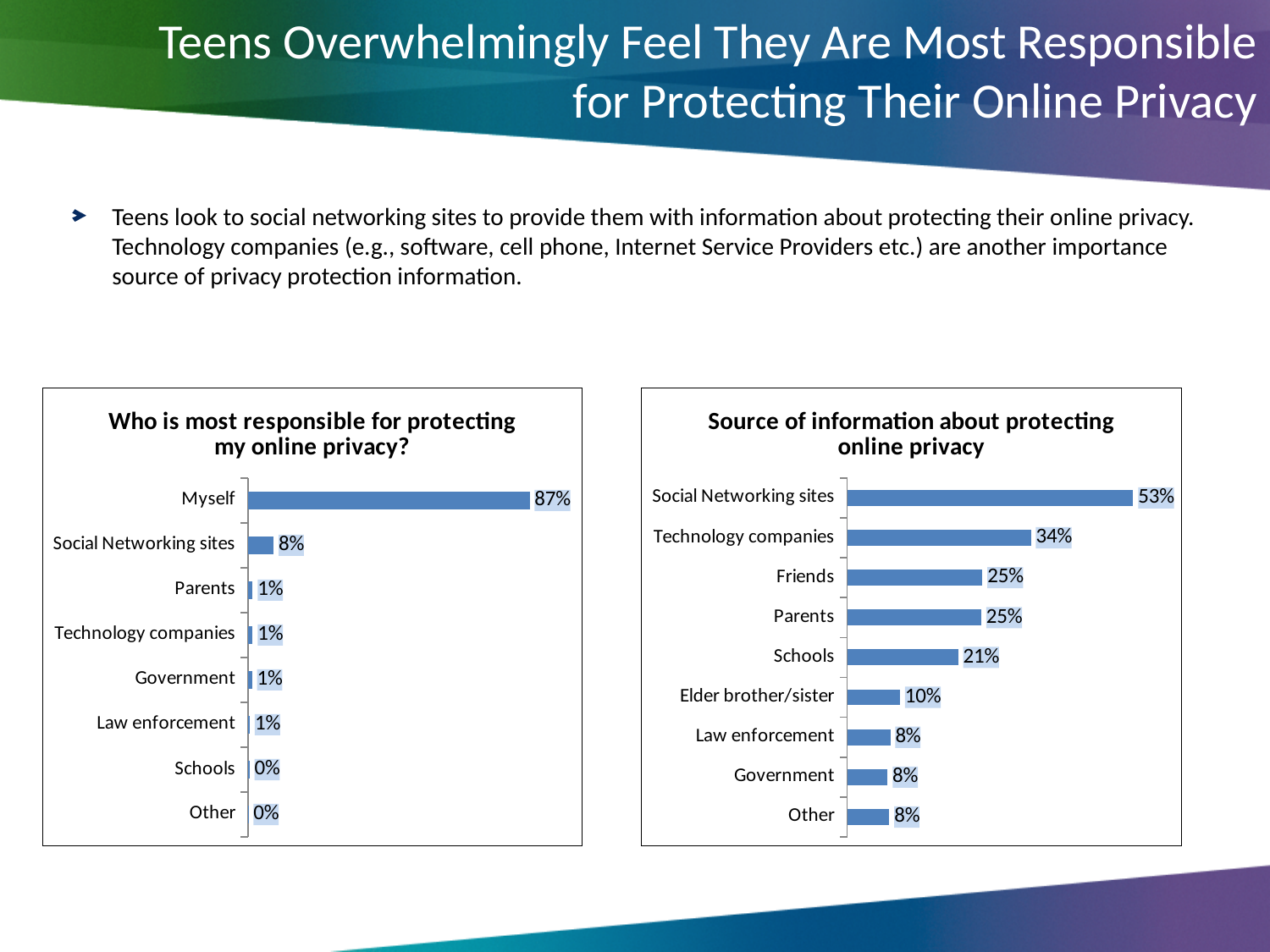
In the chart titled "Source of information about protecting online privacy", what is the value for Elder brother/sister? 10% In the chart titled "Who is most responsible for protecting my online privacy?", what is the value for Myself? 87% What type of chart is the chart on the right of the slide? Bar chart In the chart titled "Source of information about protecting online privacy", which category has the highest value? Social Networking sites In the chart titled "Who is most responsible for protecting my online privacy?", how many categories are shown? 8 In the chart titled "Who is most responsible for protecting my online privacy?", what is the difference between the values for Myself and Social Networking sites? 79% In the chart titled "Source of information about protecting online privacy", what is the difference between the values for Social Networking sites and Technology companies? 19% In the chart titled "Who is most responsible for protecting my online privacy?", what is the value for Social Networking sites? 8% In the chart titled "Source of information about protecting online privacy", what is the value for Technology companies? 34% In the chart titled "Who is most responsible for protecting my online privacy?", which category has the highest value? Myself In the chart titled "Source of information about protecting online privacy", how many categories are shown? 9 In the chart titled "Source of information about protecting online privacy", which is larger, the value for Schools or the value for Elder brother/sister? Schools